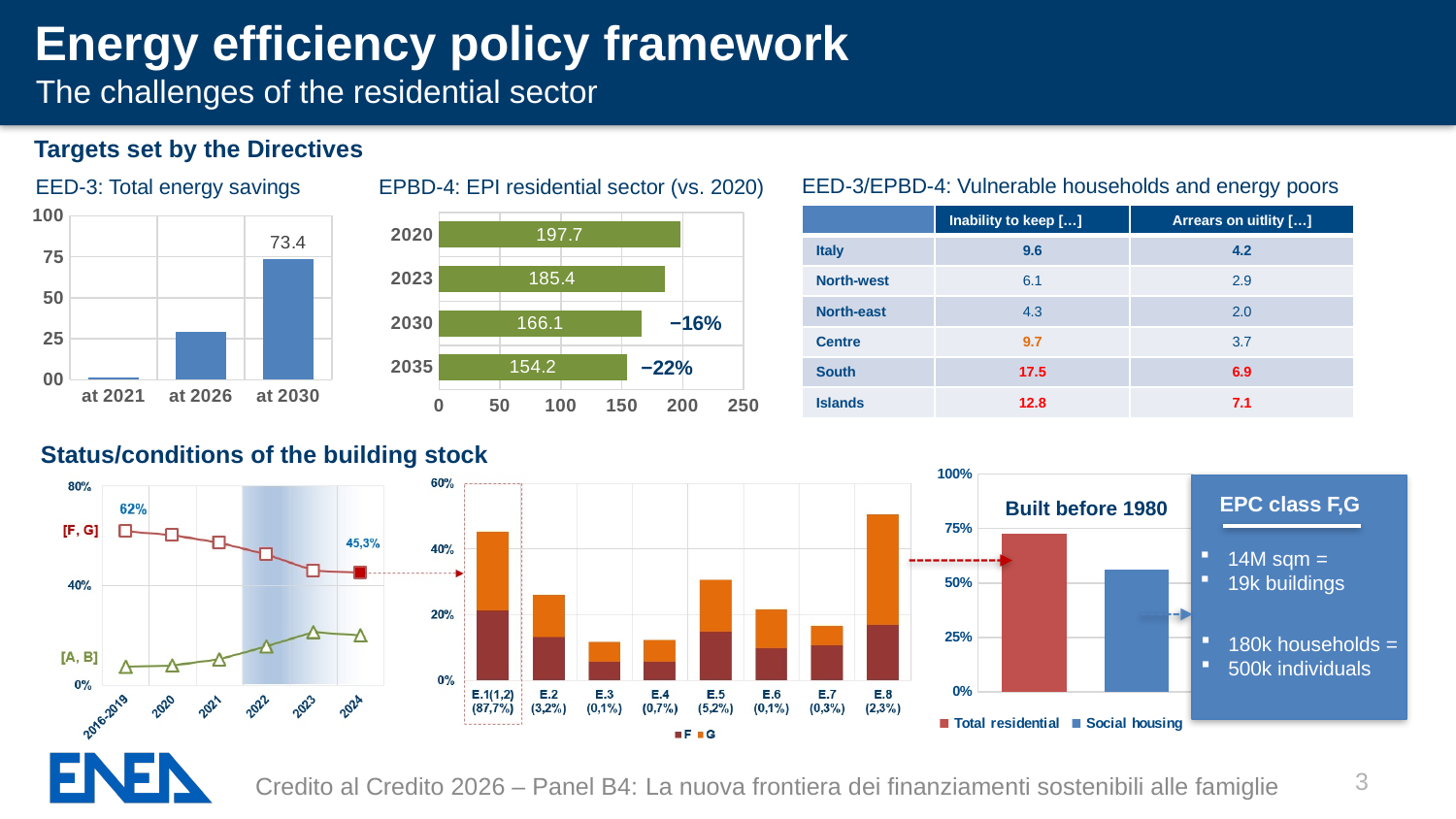
In the 'EPBD-4: EPI residential sector (vs. 2020)' chart, do the values rise or fall from 2020 to 2035? fall In the 'EPBD-4: EPI residential sector (vs. 2020)' chart, what is the value for 2023? 185.4 In the line chart under 'Status/conditions of the building stock', what is the [F, G] value at 2016-2019? 62% In the 'EED-3: Total energy savings' chart, how many categories are shown on the x axis? 3 What kind of chart is the 'EPBD-4: EPI residential sector (vs. 2020)' chart? bar chart In the 'EED-3: Total energy savings' chart, what is the value at 2030? 73.4 In the 'EPBD-4: EPI residential sector (vs. 2020)' chart, what is the value for 2035? 154.2 In the 'EED-3: Total energy savings' chart, is the value at 2026 greater or less than 50? less In the line chart under 'Status/conditions of the building stock', what is the [F, G] value at 2024? 45,3% In the 'Built before 1980' chart, which series does the legend list besides 'Total residential'? Social housing In the 'EPBD-4: EPI residential sector (vs. 2020)' chart, what is the difference between the 2020 value and the 2030 value? 31.6 In the 'EPBD-4: EPI residential sector (vs. 2020)' chart, which year has the highest value? 2020